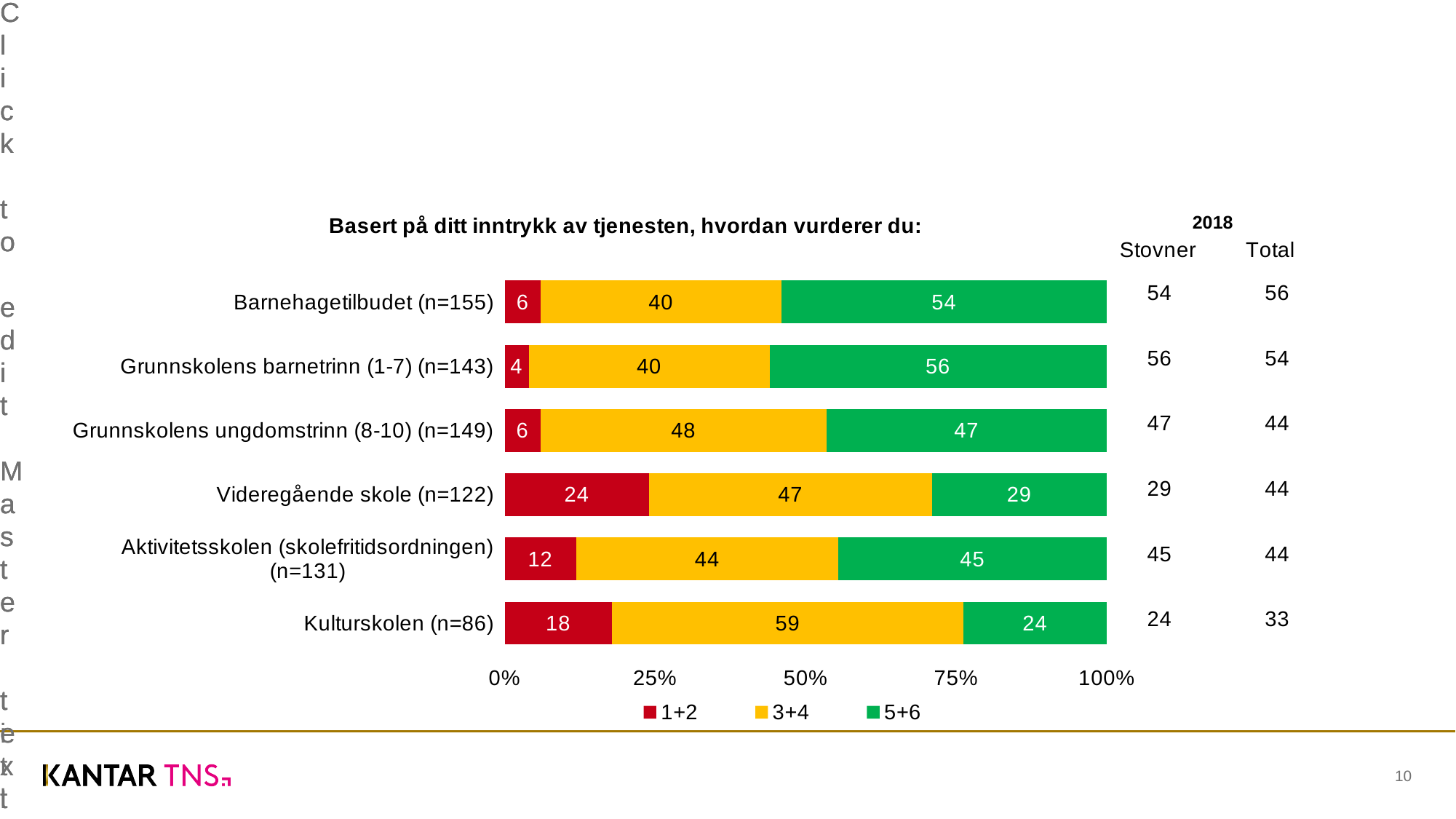
What is the value of the 1+2 series for Videregående skole (n=122)? 24 What kind of chart is shown on the slide? Stacked bar chart What is the value of the 3+4 series for Kulturskolen (n=86)? 59 Which category has the highest value in the 5+6 series? Grunnskolens barnetrinn (1-7) (n=143) What is the title of the chart? Basert på ditt inntrykk av tjenesten, hvordan vurderer du: How many categories are shown in the chart? 6 How many series does the legend list? 3 What is the value of the 5+6 series for Barnehagetilbudet (n=155)? 54 Which category has the lowest value in the 5+6 series? Kulturskolen (n=86) Which is larger: the 5+6 value for Aktivitetsskolen (skolefritidsordningen) (n=131) or for Videregående skole (n=122)? Aktivitetsskolen (skolefritidsordningen) (n=131) What is the difference between the 3+4 values for Kulturskolen (n=86) and Barnehagetilbudet (n=155)? 19 Which category has the highest value in the 1+2 series? Videregående skole (n=122)